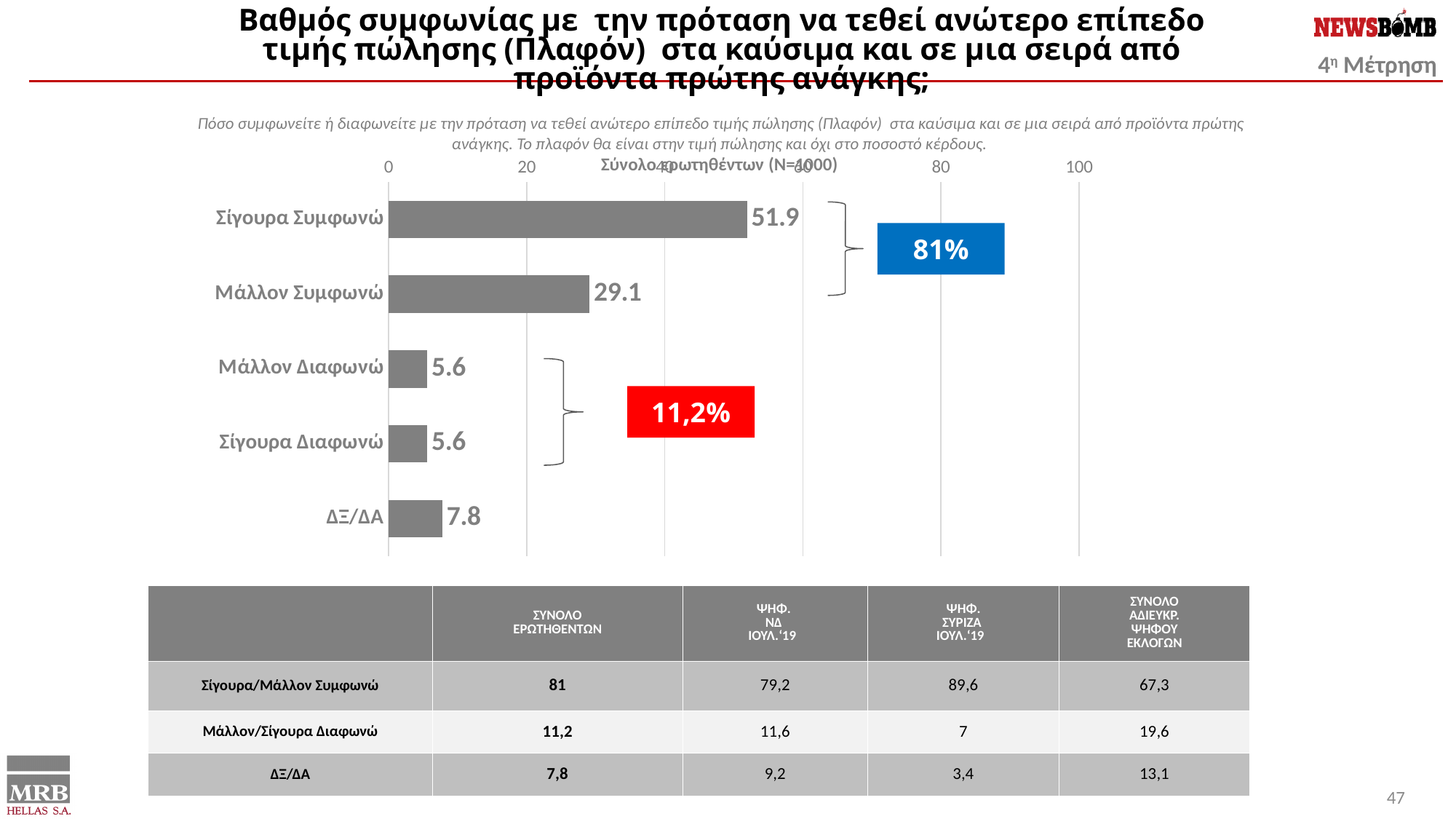
What is the value for Σίγουρα Διαφωνώ? 5.6 How many categories are shown in the chart? 5 What is the value for Μάλλον Συμφωνώ? 29.1 What is the value for Σίγουρα Συμφωνώ? 51.9 Which is larger, ΔΞ/ΔΑ or Μάλλον Διαφωνώ? ΔΞ/ΔΑ Which category has the highest value? Σίγουρα Συμφωνώ Is the value for Σίγουρα Συμφωνώ greater or less than 40? greater What is the value for ΔΞ/ΔΑ? 7.8 What is the difference between Σίγουρα Συμφωνώ and Μάλλον Συμφωνώ? 22.8 What kind of chart is shown? bar chart What combined percentage is shown in the red box for the two disagree categories? 11,2% What combined percentage is shown in the blue box for the two agree categories? 81%